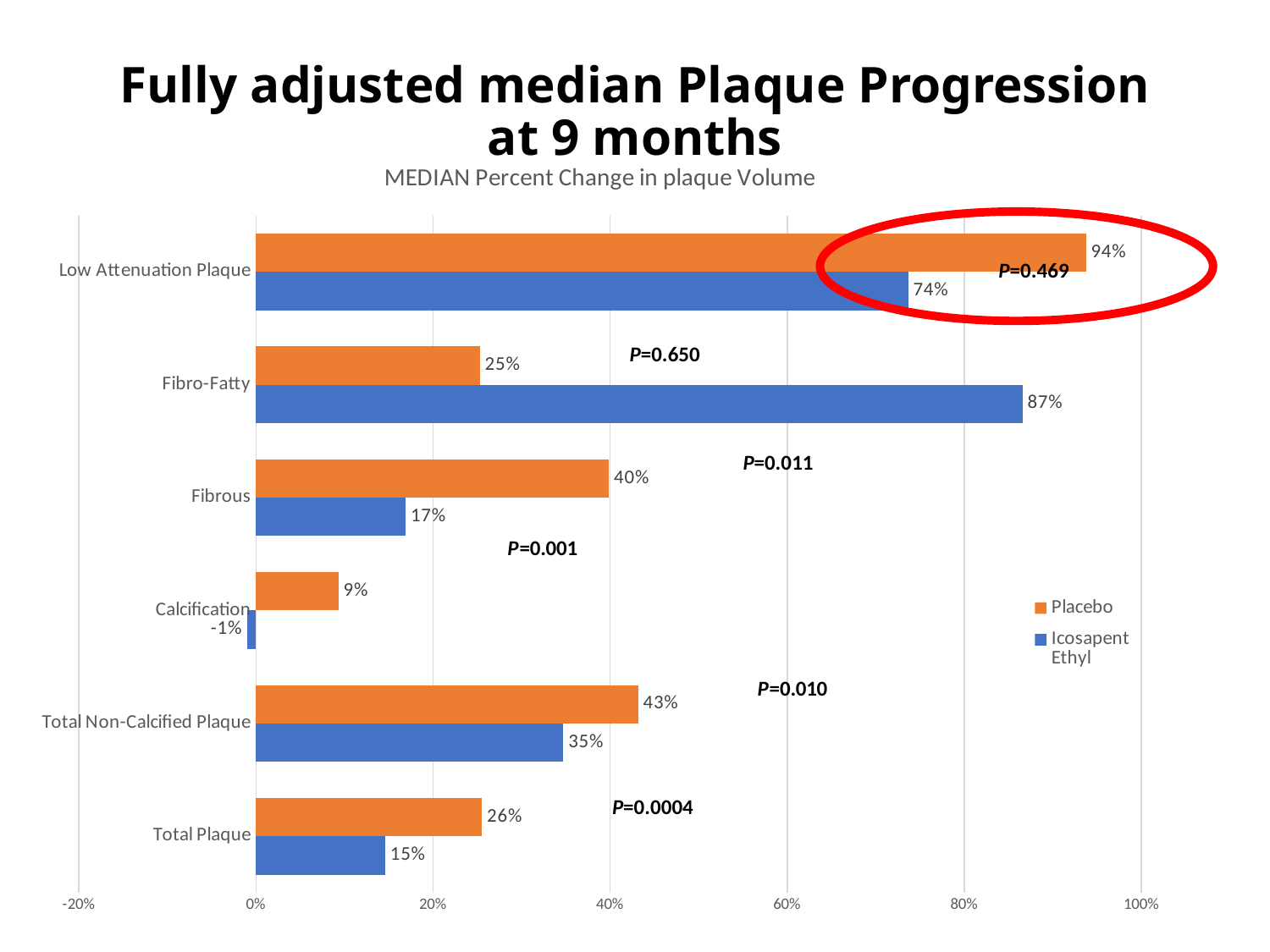
Which category has the highest Placebo value? Low Attenuation Plaque What is the Placebo value for Low Attenuation Plaque? 94% What kind of chart is shown on the slide? Bar chart What is the difference between the Placebo and Icosapent Ethyl values for Fibrous? 23% What is the Icosapent Ethyl value for Fibro-Fatty? 87% How many plaque categories are shown on the chart? 6 For Fibro-Fatty, which series has the larger value, Placebo or Icosapent Ethyl? Icosapent Ethyl How many series does the legend list? 2 What is the Placebo value for Total Plaque? 26% What P value is shown next to the Low Attenuation Plaque bars? P=0.469 What is the Icosapent Ethyl value for Calcification? -1% Which category has the lowest Icosapent Ethyl value? Calcification